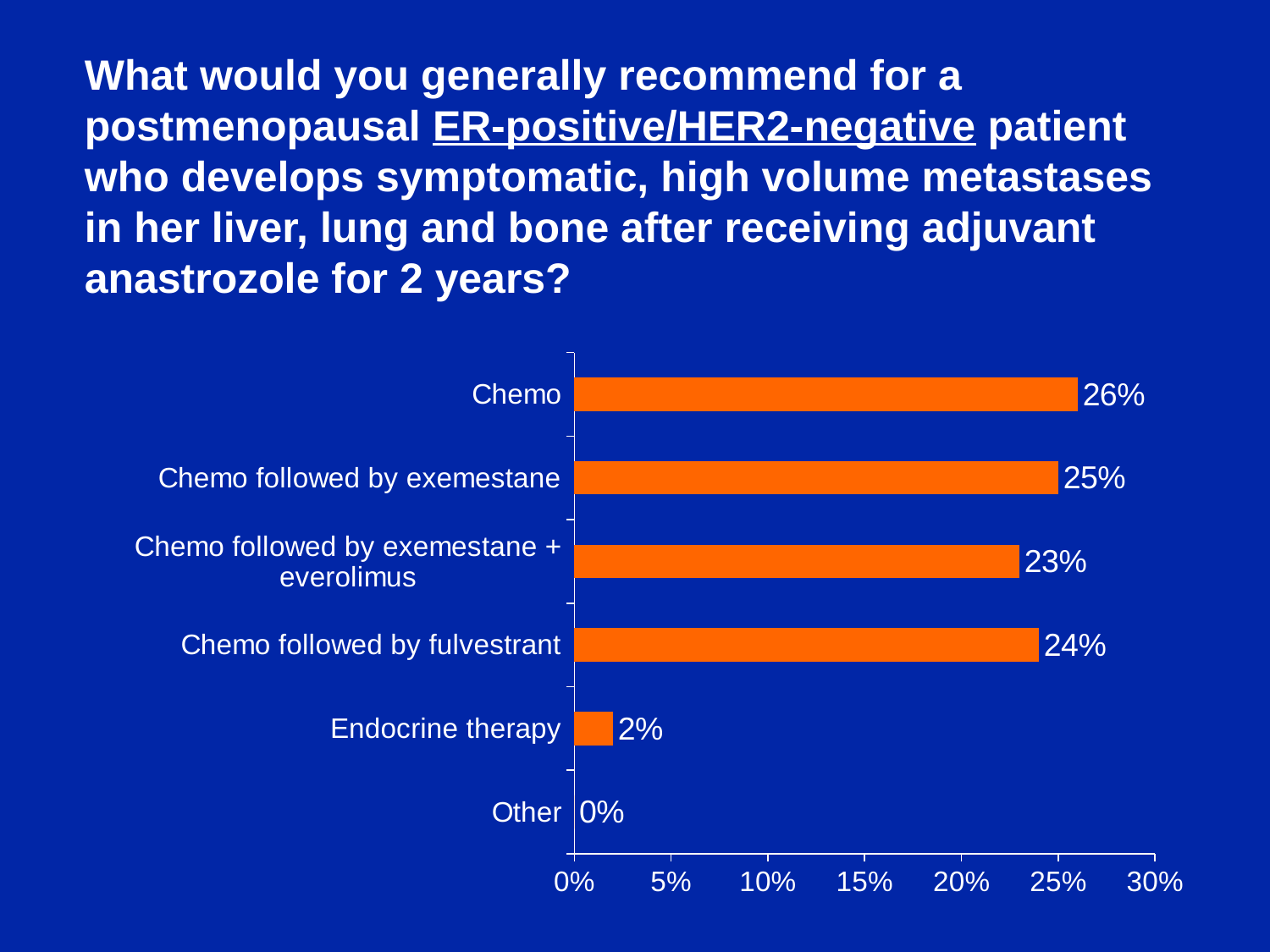
Which category has the highest value? Chemo How many categories are shown in the chart? 6 What is the value for Chemo followed by exemestane + everolimus? 23% Is the value for Chemo followed by exemestane greater or less than 20%? greater What is the value for Other? 0% What percentage of respondents recommended Chemo? 26% What kind of chart is shown on the slide? Bar chart What is the difference between Chemo followed by fulvestrant and Chemo followed by exemestane + everolimus? 1% Which is larger: the value for Chemo followed by fulvestrant or the value for Endocrine therapy? Chemo followed by fulvestrant Which category has the lowest value? Other What is the value for Endocrine therapy? 2% What is the difference between the values for Chemo and Endocrine therapy? 24%